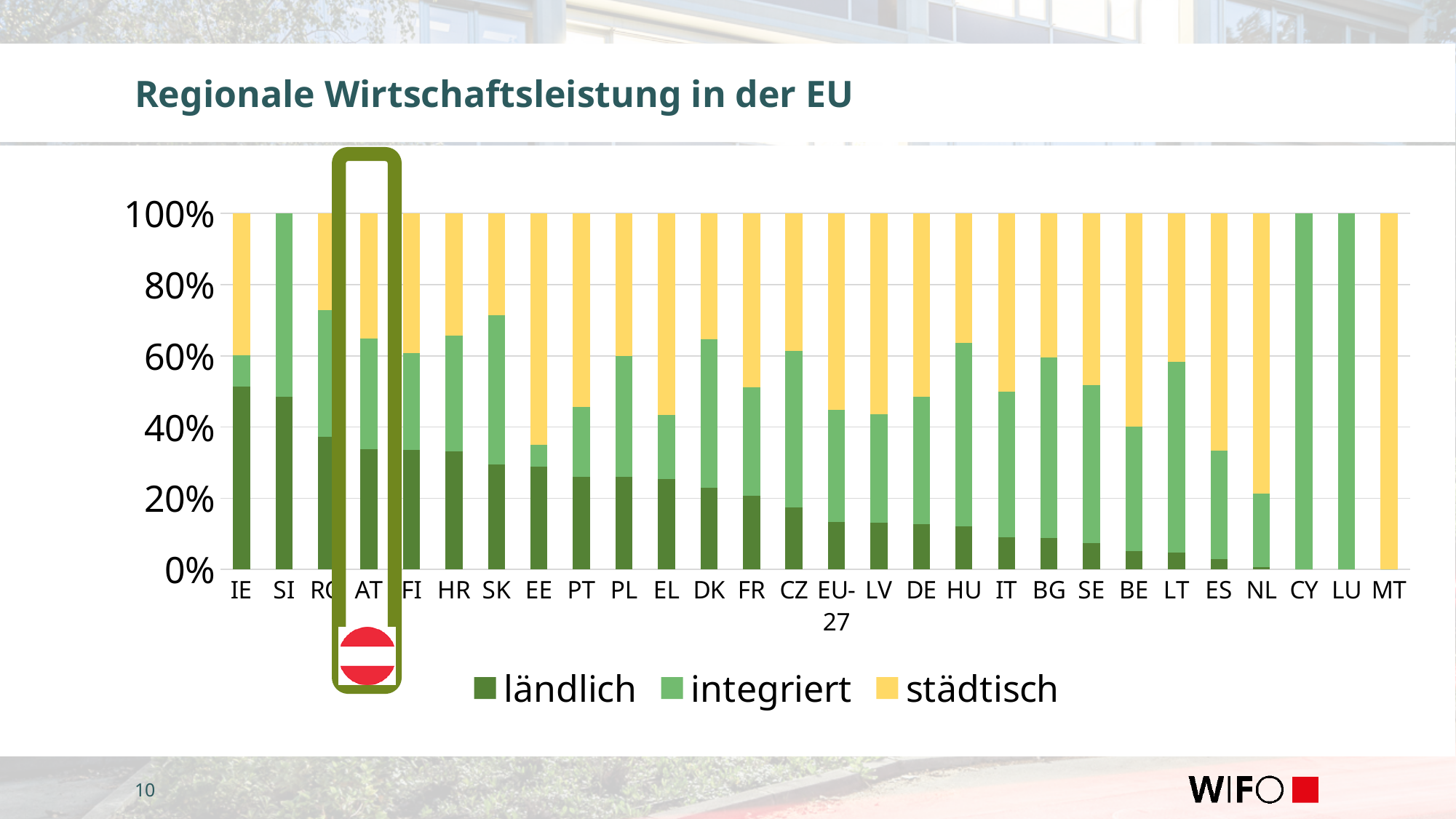
How many categories are shown on the x axis? 28 How many series does the legend list? 3 Is the ländlich value for DE greater or less than 20%? less Which has the larger ländlich share, IE or DE? IE Is the ländlich value for AT greater or less than 40%? less Which category is highlighted with a frame and a flag on the slide? AT What kind of chart is shown on the slide? Stacked bar chart Is the ländlich value for NL greater or less than 20%? less Which category has the largest städtisch share? MT What are the three series named in the legend? ländlich, integriert, städtisch What is the total of the stacked bar for MT? 100%